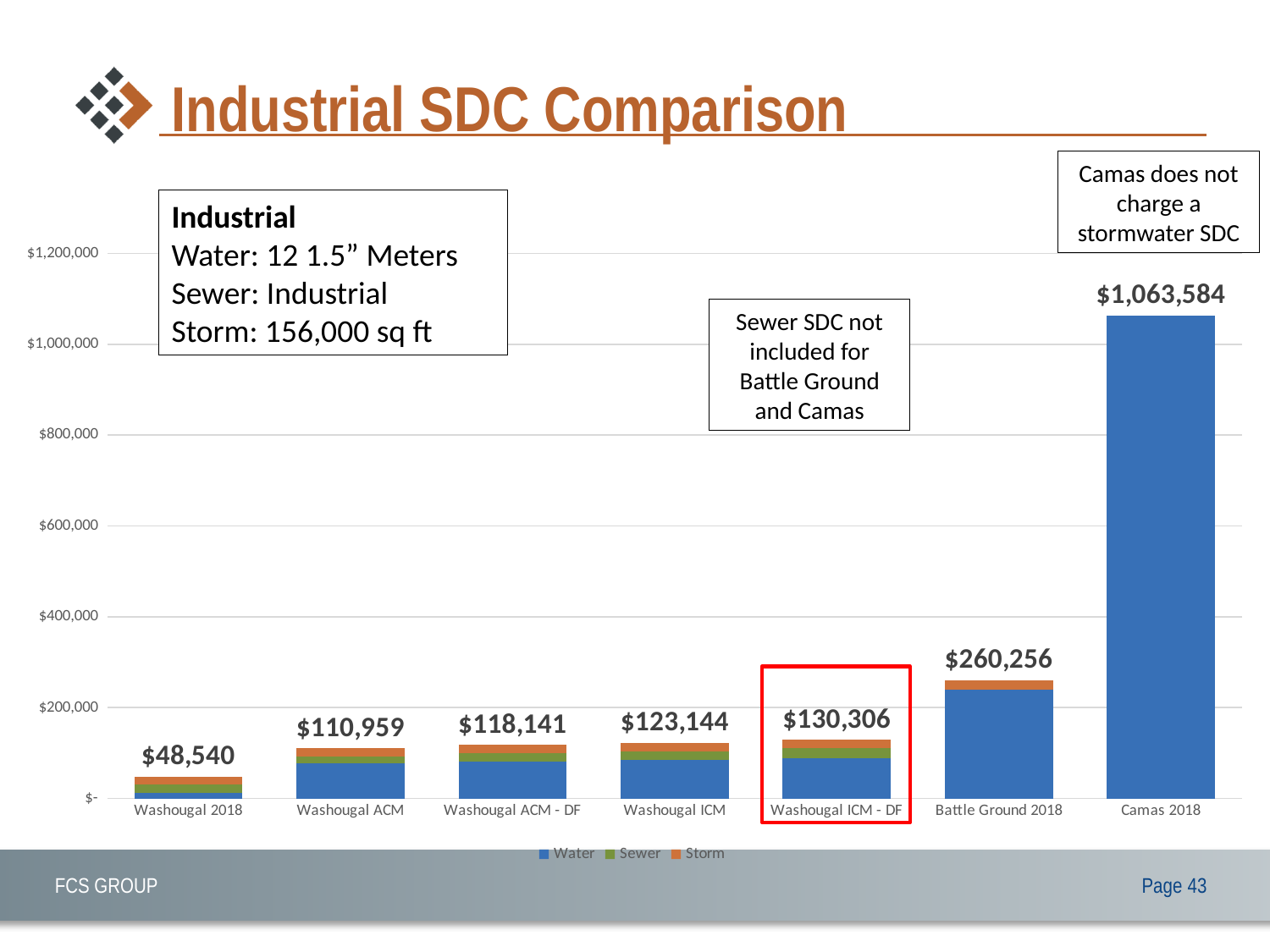
What kind of chart is shown on the slide? Stacked bar chart What is the total labeled for Battle Ground 2018? $260,256 What is the total labeled for Washougal ICM - DF? $130,306 How many categories are shown on the x axis? 7 Which is larger, the total for Washougal ICM or the total for Washougal ACM - DF? Washougal ICM Is the total for Battle Ground 2018 greater or less than $200,000? greater How many series does the legend list? 3 Which category has the lowest total? Washougal 2018 What is the total labeled for Camas 2018? $1,063,584 What is the difference between the totals for Washougal ACM - DF and Washougal ACM? $7,182 Which category has the highest total? Camas 2018 What is the difference between the totals for Battle Ground 2018 and Washougal ICM - DF? $129,950